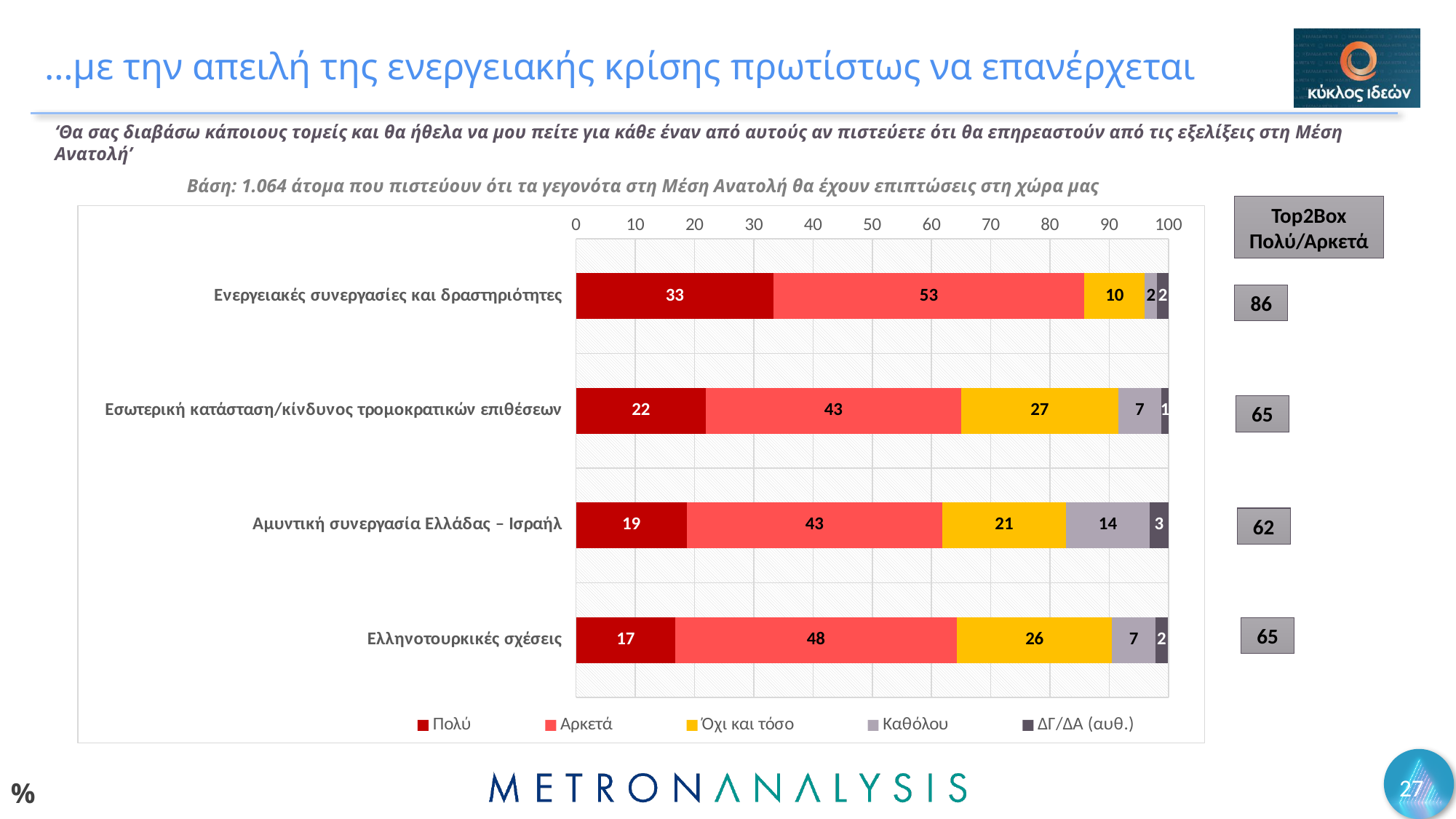
What is the Top2Box (Πολύ/Αρκετά) value for 'Ελληνοτουρκικές σχέσεις'? 65 Which is larger: the 'Όχι και τόσο' value for 'Ελληνοτουρκικές σχέσεις' or for 'Αμυντική συνεργασία Ελλάδας – Ισραήλ'? Ελληνοτουρκικές σχέσεις How many series does the legend list? 5 What is the combined total of 'Πολύ' and 'Αρκετά' for 'Αμυντική συνεργασία Ελλάδας – Ισραήλ'? 62 What is the difference between the 'Αρκετά' values for 'Ενεργειακές συνεργασίες και δραστηριότητες' and 'Ελληνοτουρκικές σχέσεις'? 5 How many categories are shown in the chart? 4 What is the value of 'Καθόλου' for 'Αμυντική συνεργασία Ελλάδας – Ισραήλ'? 14 Which category has the highest 'Πολύ' value? Ενεργειακές συνεργασίες και δραστηριότητες What is the value of 'Όχι και τόσο' for 'Εσωτερική κατάσταση/κίνδυνος τρομοκρατικών επιθέσεων'? 27 What kind of chart is shown on the slide? Stacked bar chart Which category has the lowest 'Πολύ' value? Ελληνοτουρκικές σχέσεις What is the value of 'Πολύ' for 'Ενεργειακές συνεργασίες και δραστηριότητες'? 33